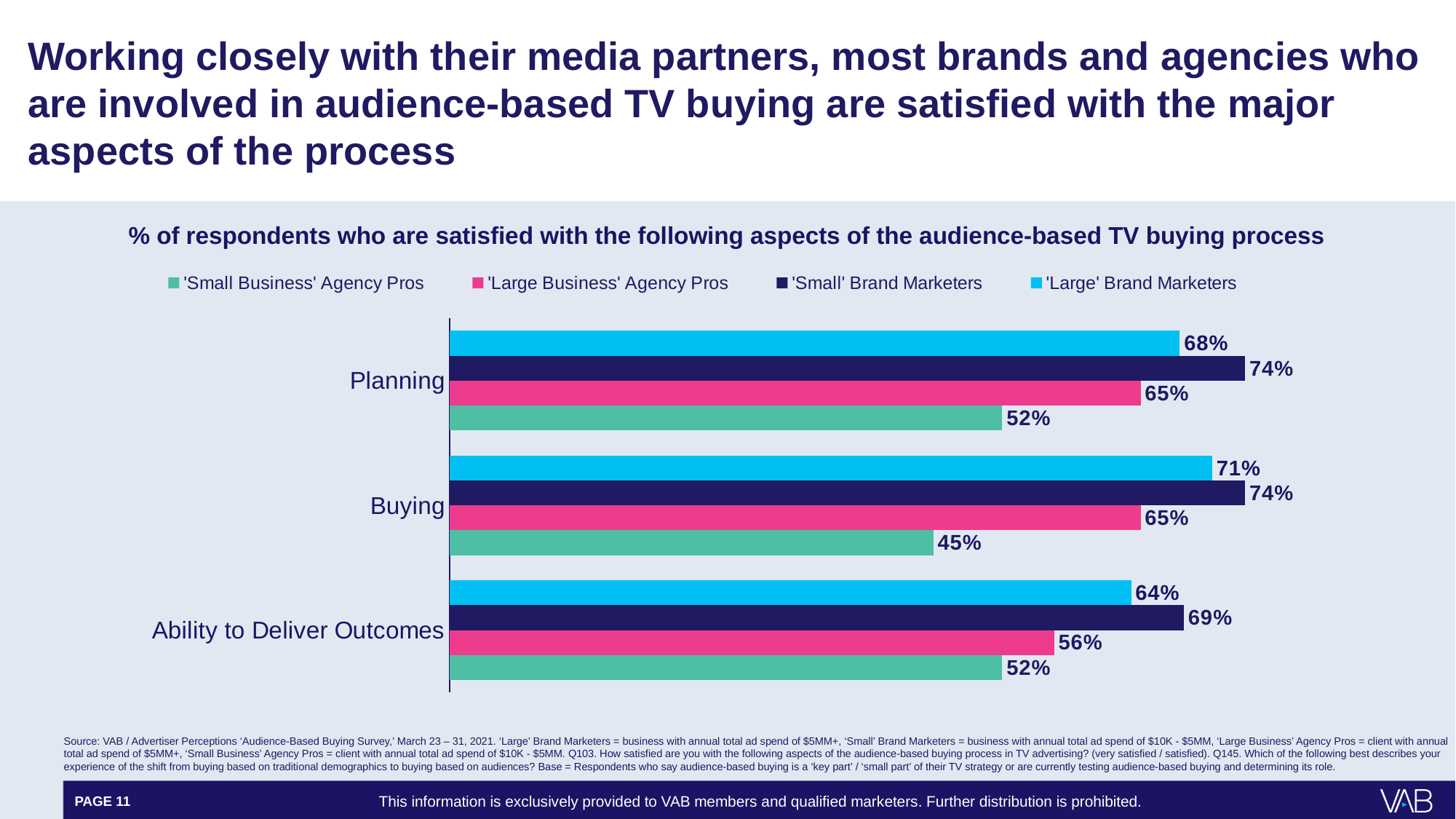
What percentage of 'Small' Brand Marketers are satisfied with Planning? 74% What is the difference between 'Small' Brand Marketers and 'Small Business' Agency Pros for Buying? 29 percentage points Which series has the highest satisfaction for Ability to Deliver Outcomes? 'Small' Brand Marketers What is the difference between 'Large' Brand Marketers for Buying and for Planning? 3 percentage points How many series does the legend list? 4 What percentage of 'Large Business' Agency Pros are satisfied with Ability to Deliver Outcomes? 56% Which is larger: 'Large' Brand Marketers for Planning or 'Large Business' Agency Pros for Planning? 'Large' Brand Marketers for Planning How many aspects of the buying process are shown on the chart? 3 Which series has the lowest satisfaction for Buying? 'Small Business' Agency Pros What type of chart is shown on the slide? Bar chart What percentage of 'Small Business' Agency Pros are satisfied with Buying? 45% What percentage of 'Large' Brand Marketers are satisfied with Ability to Deliver Outcomes? 64%